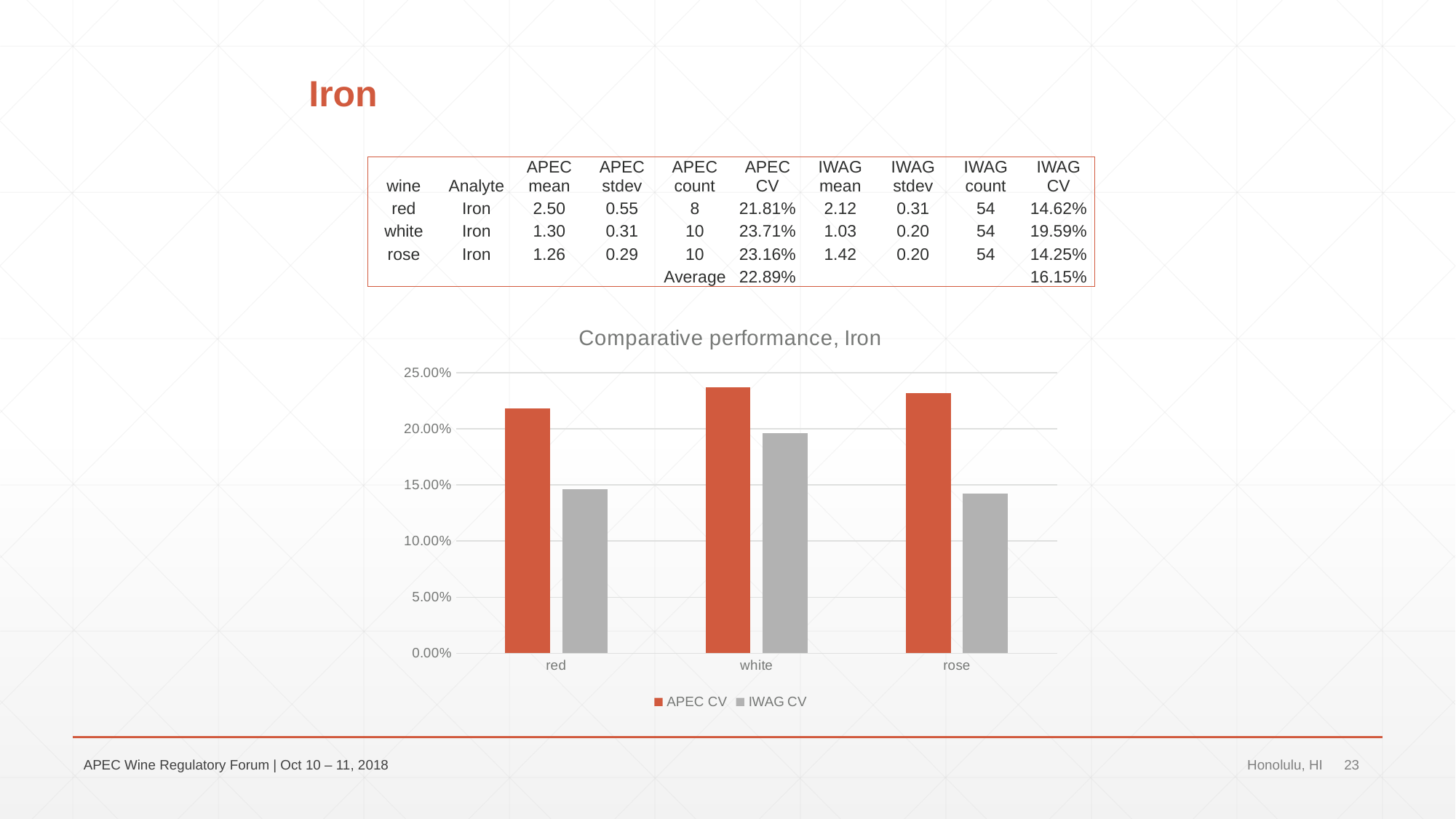
What type of chart is shown under the title "Comparative performance, Iron"? bar chart What is the APEC CV value for white wine? 23.71% How many wine categories are shown on the x axis of the chart? 3 Is the IWAG CV value for white wine greater or less than 15.00%? greater What is the IWAG CV value for rose wine? 14.25% Which series is shown in orange in the chart? APEC CV For red wine, which is larger, the APEC CV or the IWAG CV? APEC CV Which wine has the highest APEC CV? white How many series does the chart legend list? 2 What is the difference between the APEC CV and the IWAG CV for white wine? 4.12% Is the APEC CV value for red wine greater or less than 20.00%? greater What is the title of the chart? Comparative performance, Iron